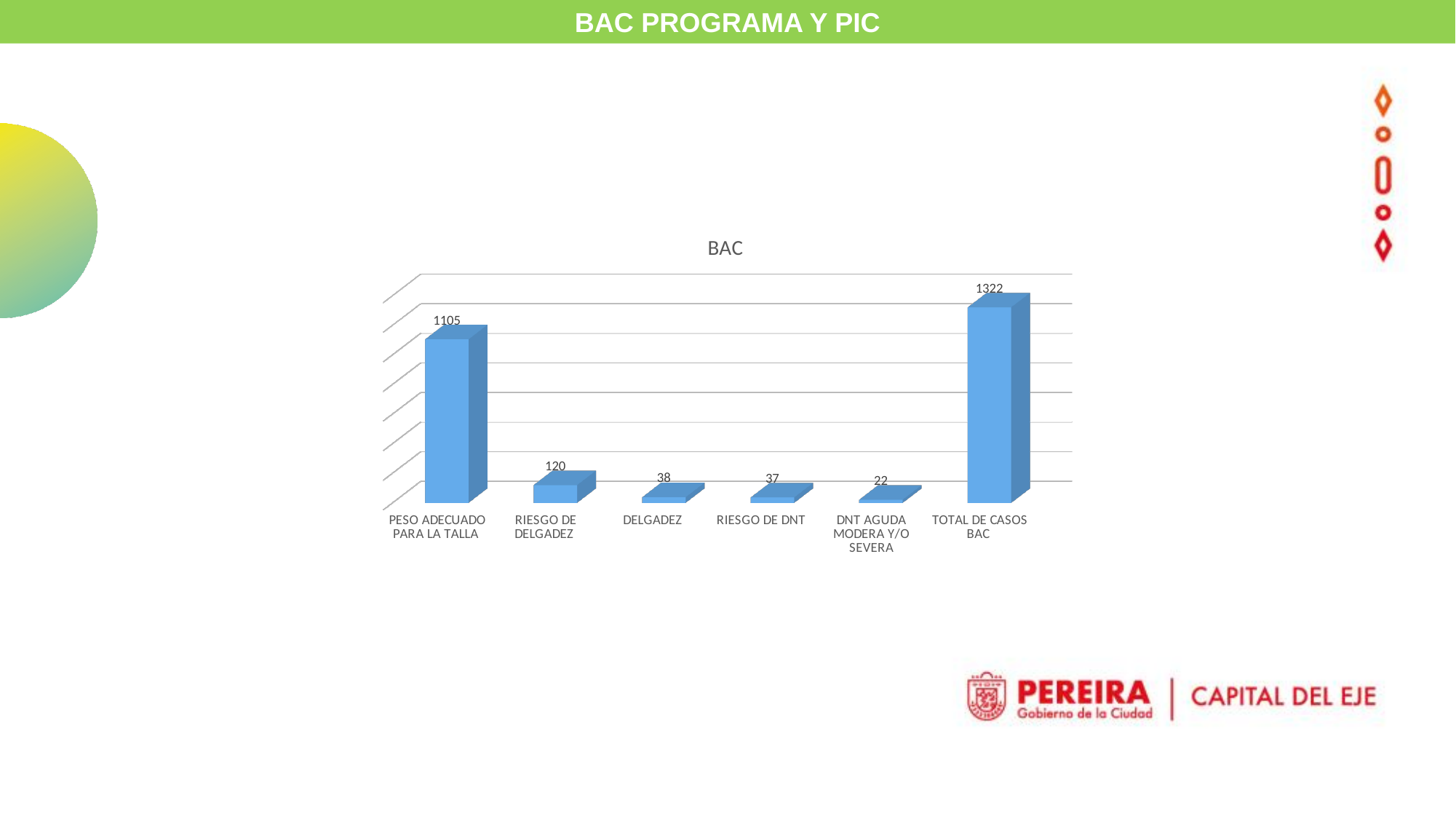
Which category has the lowest value? DNT AGUDA MODERA Y/O SEVERA Which is larger, RIESGO DE DELGADEZ or DELGADEZ? RIESGO DE DELGADEZ What kind of chart is shown? Bar chart What is the value for TOTAL DE CASOS BAC? 1322 What is the value for PESO ADECUADO PARA LA TALLA? 1105 What is the value for RIESGO DE DELGADEZ? 120 How many categories are shown in the chart? 6 What is the value for DNT AGUDA MODERA Y/O SEVERA? 22 What is the title of the chart? BAC Which category has the highest value? TOTAL DE CASOS BAC What is the value for DELGADEZ? 38 What is the difference between TOTAL DE CASOS BAC and PESO ADECUADO PARA LA TALLA? 217